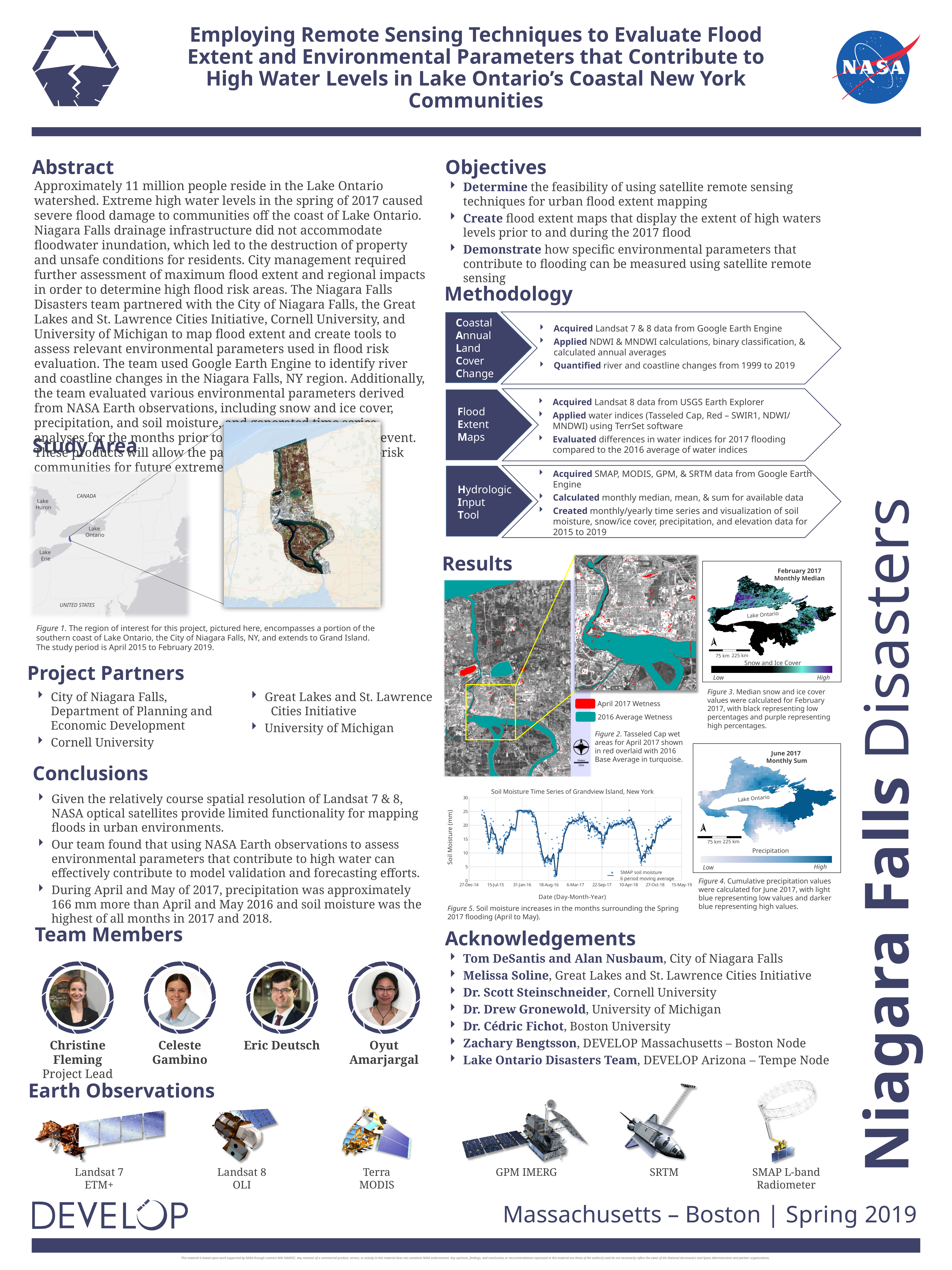
How many date ticks are labelled on the x axis of the Soil Moisture Time Series chart? 9 What is the highest tick value shown on the y axis of the Soil Moisture Time Series chart? 30 What are the two legend entries on the Soil Moisture Time Series chart? SMAP soil moisture; 6 period moving average What is the label of the y axis on the Soil Moisture Time Series chart? Soil Moisture (mm) How many series does the legend of the Soil Moisture Time Series chart list? 2 On the Soil Moisture Time Series chart, is the soil moisture around 31-Jan-16 greater or less than 20? greater What kind of chart is the Soil Moisture Time Series chart? line chart On the Soil Moisture Time Series chart, is the soil moisture around 18-Aug-16 greater or less than 10? less On the Soil Moisture Time Series chart, which is larger: the soil moisture around 31-Jan-16 or around 18-Aug-16? 31-Jan-16 On the Soil Moisture Time Series chart, is the soil moisture around 10-Apr-18 greater or less than 15? greater What is the title of the chart in the Results section? Soil Moisture Time Series of Grandview Island, New York